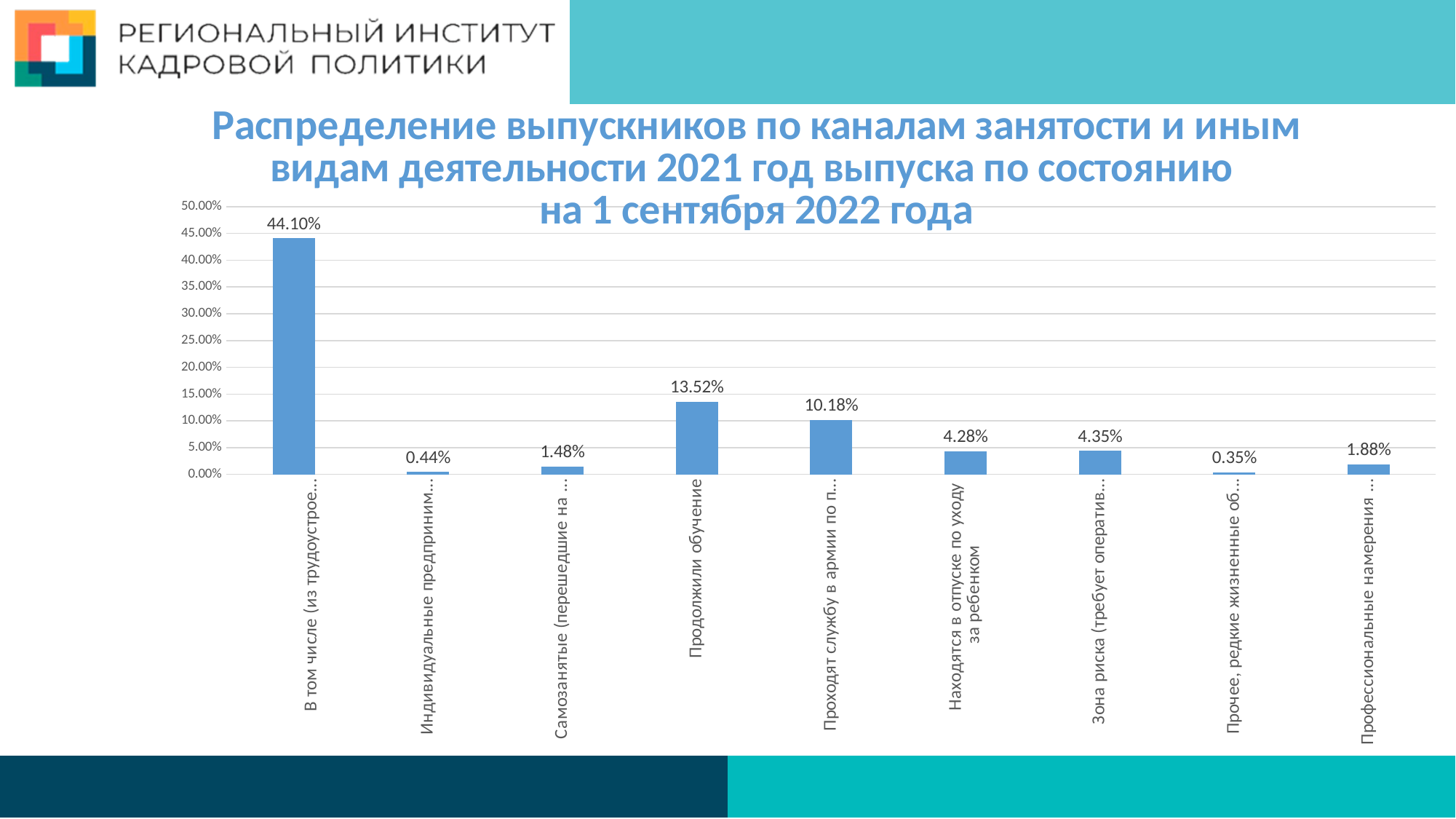
What is the value for the category whose label begins "Самозанятые"? 1.48% What kind of chart is shown on the slide? Bar chart How many categories (bars) does the chart show? 9 What is the value for the category whose label begins "Проходят службу в армии"? 10.18% Which category has the lowest value? Прочее, редкие жизненные об... What is the difference between the values for "Продолжили обучение" and the category beginning "Проходят службу в армии"? 3.34% Which category has the highest value? В том числе (из трудоустрое...) What is the highest value shown on the vertical axis? 50.00% Is the value for the category beginning "В том числе" greater or less than 40.00%? greater Which is larger: the value for the category beginning "Зона риска" or the value for "Находятся в отпуске по уходу за ребенком"? Зона риска What is the value for the category "Находятся в отпуске по уходу за ребенком"? 4.28% What is the value for the category "Продолжили обучение"? 13.52%